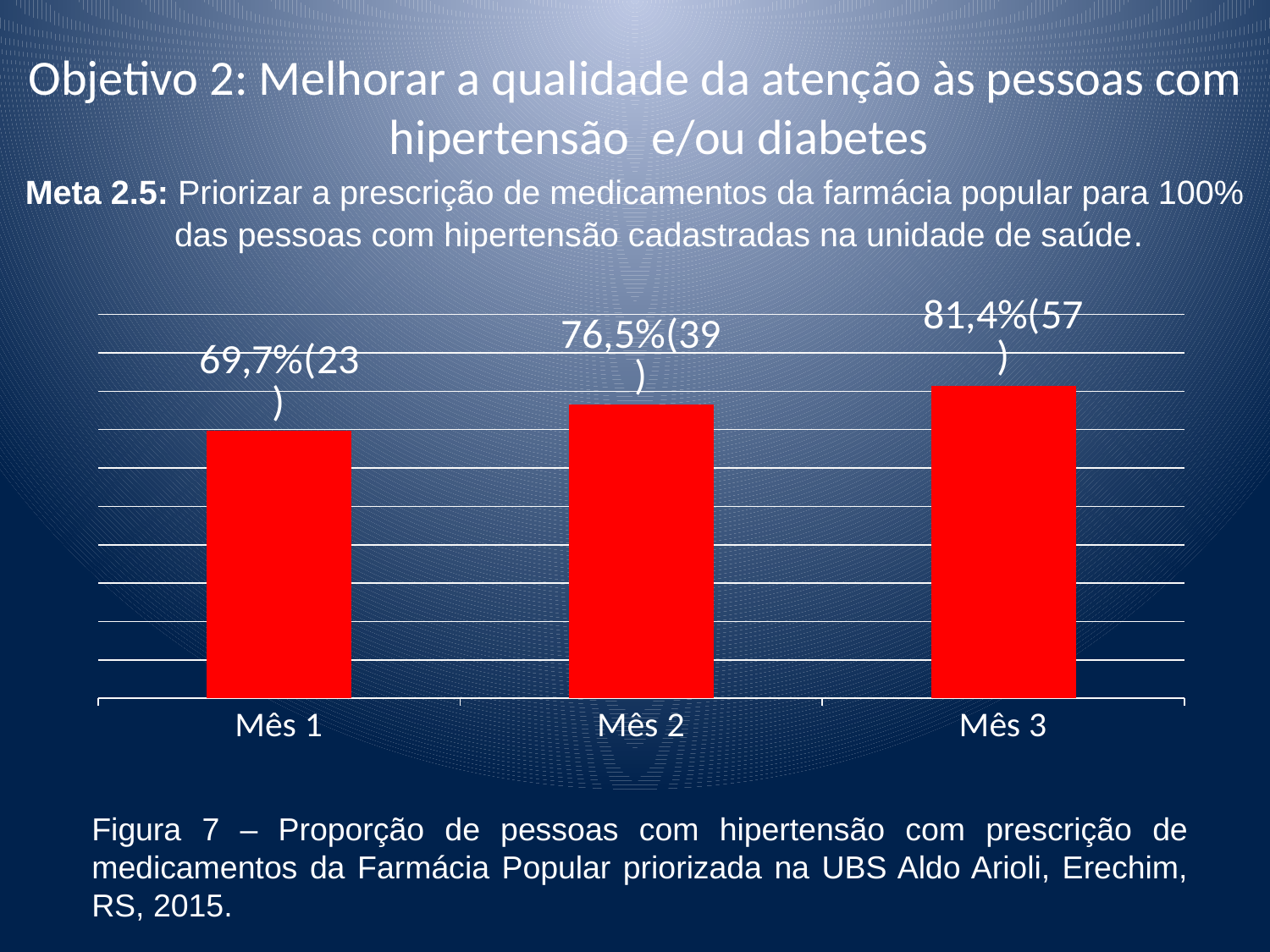
What is the difference in percentage points between Mês 2 and Mês 1? 6,8 What is the value shown for Mês 2? 76,5%(39) What is the difference in percentage points between Mês 3 and Mês 1? 11,7 Which month has the highest proportion? Mês 3 Which is larger, the value for Mês 2 or the value for Mês 3? Mês 3 What colour are the bars in the chart? Red Do the values rise or fall from Mês 1 to Mês 3? Rise How many months (categories) are shown in the chart? 3 What is the value shown for Mês 1? 69,7%(23) What is the value shown for Mês 3? 81,4%(57) What kind of chart is shown on the slide? Bar chart Which month has the lowest proportion? Mês 1